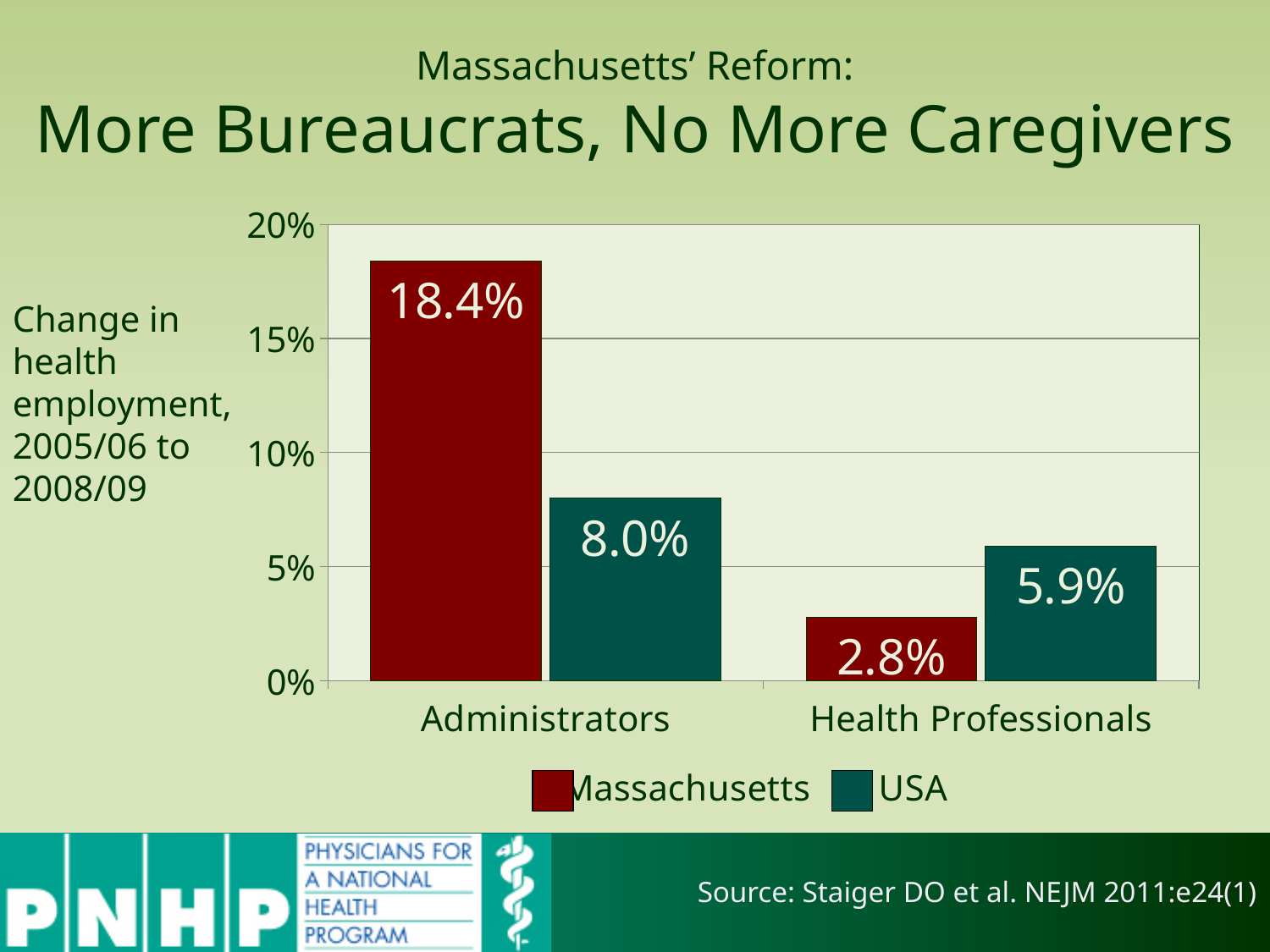
For Health Professionals, which is larger: the Massachusetts value or the USA value? USA What is the change in health employment for Administrators in Massachusetts? 18.4% Which bar shows the highest value on the chart? Massachusetts, Administrators What is the value for Health Professionals in Massachusetts? 2.8% How many categories are shown on the x axis? 2 What kind of chart is shown on the slide? Bar chart What is the value for Administrators in the USA? 8.0% How many series does the legend list? 2 Which bar shows the lowest value on the chart? Massachusetts, Health Professionals What is the change in health employment for Health Professionals in the USA? 5.9% Is the Massachusetts value for Administrators greater or less than 15%? greater What is the difference between the Massachusetts and USA values for Administrators? 10.4%